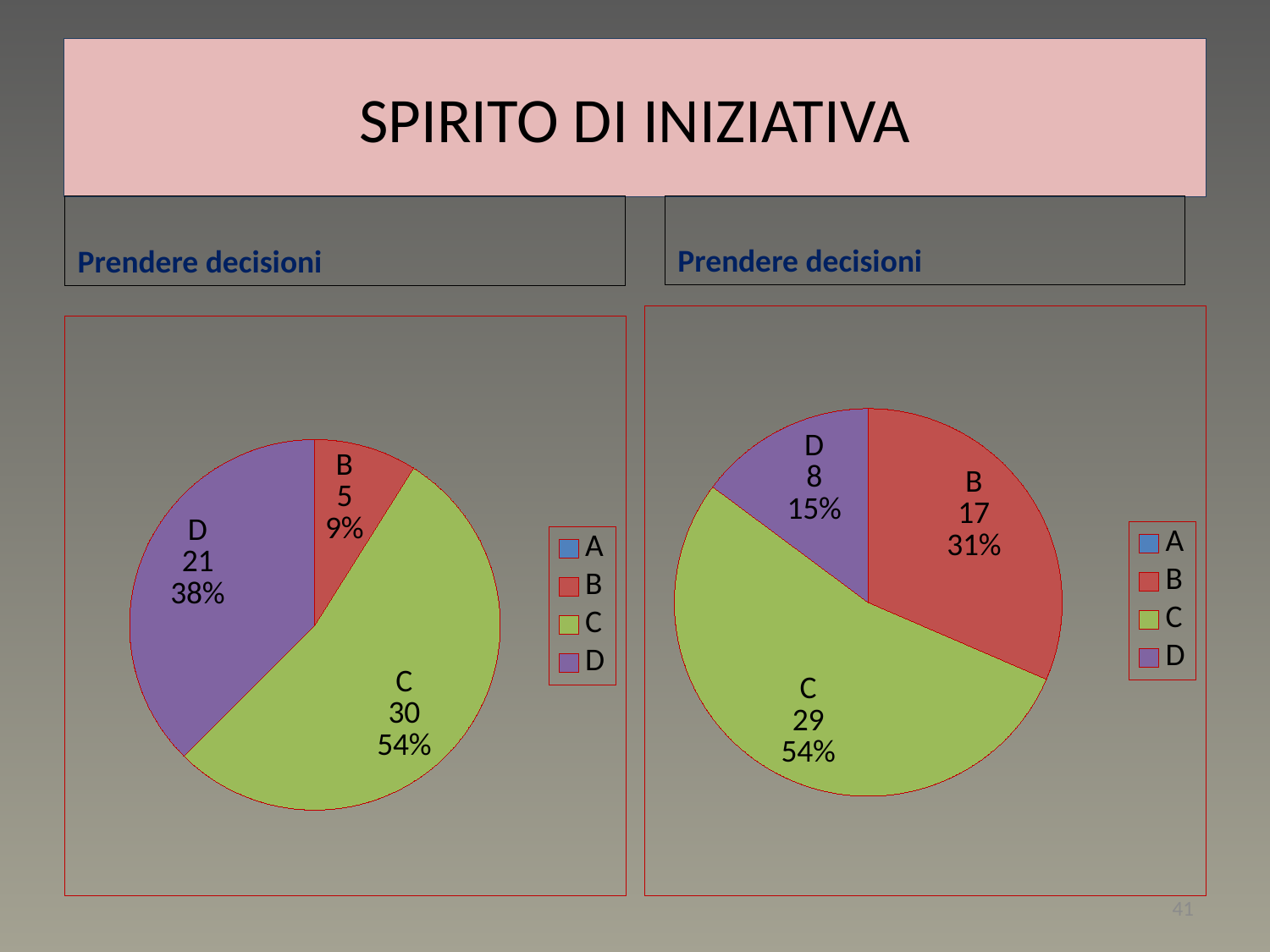
In the right pie chart, which category has the largest slice? C What type of chart is shown on the left side of the slide? Pie chart In the left pie chart, what is the value for category C? 30 In the left pie chart, what is the value for category B? 5 In the right pie chart, what is the difference between the values for C and B? 12 In the left pie chart, which labelled category has the smallest slice? B How many entries does the legend of the right pie chart list? 4 In the left pie chart, which is larger, the value for D or the value for B? D In the left pie chart, what percentage share does category D have? 38% What is the title shown above the left pie chart? Prendere decisioni In the right pie chart, what percentage share does category D have? 15% In the right pie chart, what is the value for category B? 17